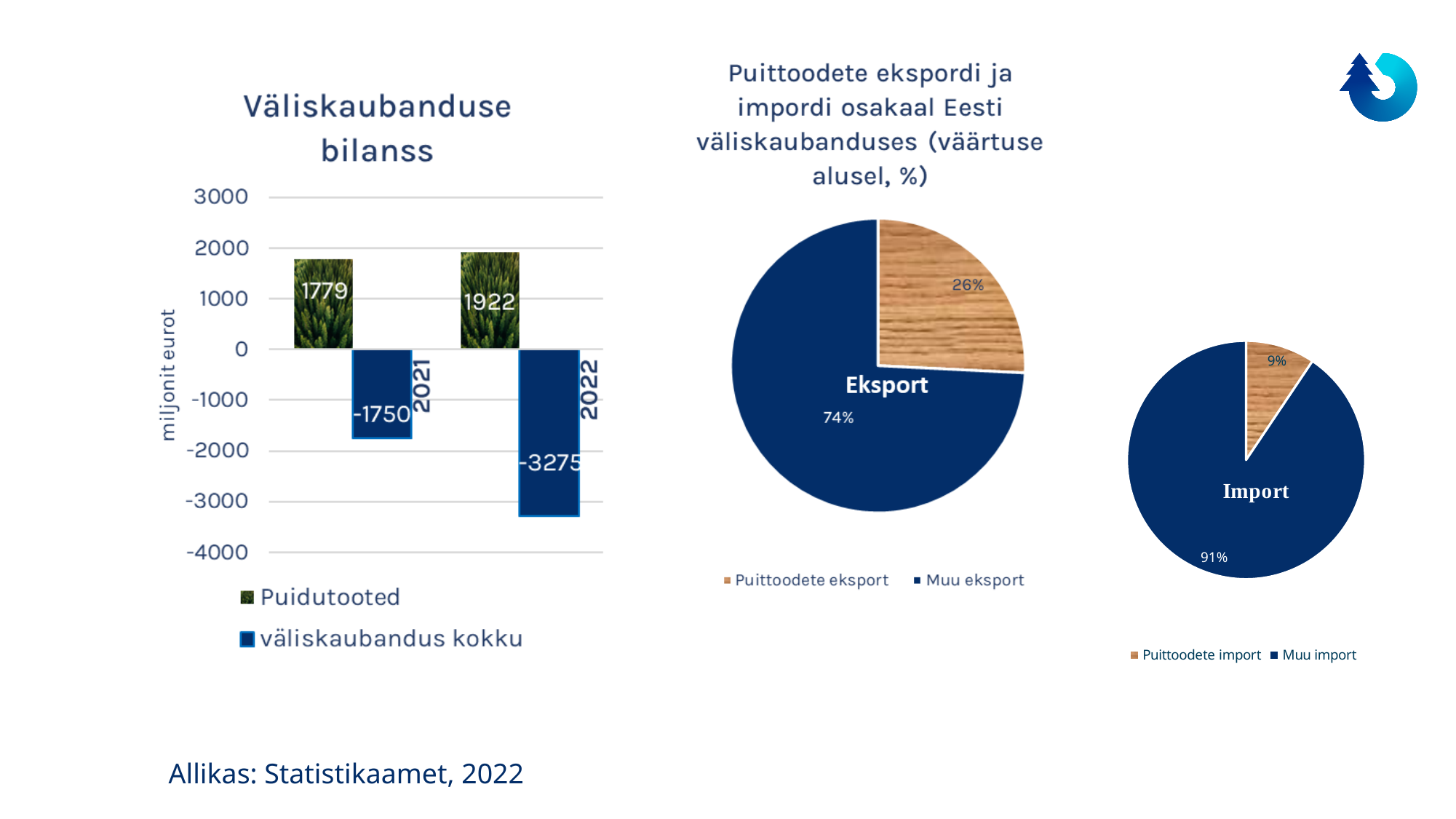
In the 'Väliskaubanduse bilanss' chart, how many series does the legend list? 2 In the Import pie chart, which slice is larger, Puittoodete import or Muu import? Muu import In the 'Väliskaubanduse bilanss' chart, what is the value for Puidutooted in 2021? 1779 In the Eksport pie chart, what share does Puittoodete eksport have? 26% In the 'Väliskaubanduse bilanss' chart, what is the value for väliskaubandus kokku in 2021? -1750 In the 'Väliskaubanduse bilanss' chart, by how much did the Puidutooted value increase from 2021 to 2022? 143 In the 'Väliskaubanduse bilanss' chart, what unit is shown on the vertical axis? miljonit eurot In the 'Väliskaubanduse bilanss' chart, what kind of chart is it? Bar chart In the Import pie chart, what share does Muu import have? 91% In the 'Väliskaubanduse bilanss' chart, what is the value for väliskaubandus kokku in 2022? -3275 In the 'Väliskaubanduse bilanss' chart, does the Puidutooted value rise or fall from 2021 to 2022? Rise In the 'Väliskaubanduse bilanss' chart, what is the value for Puidutooted in 2022? 1922